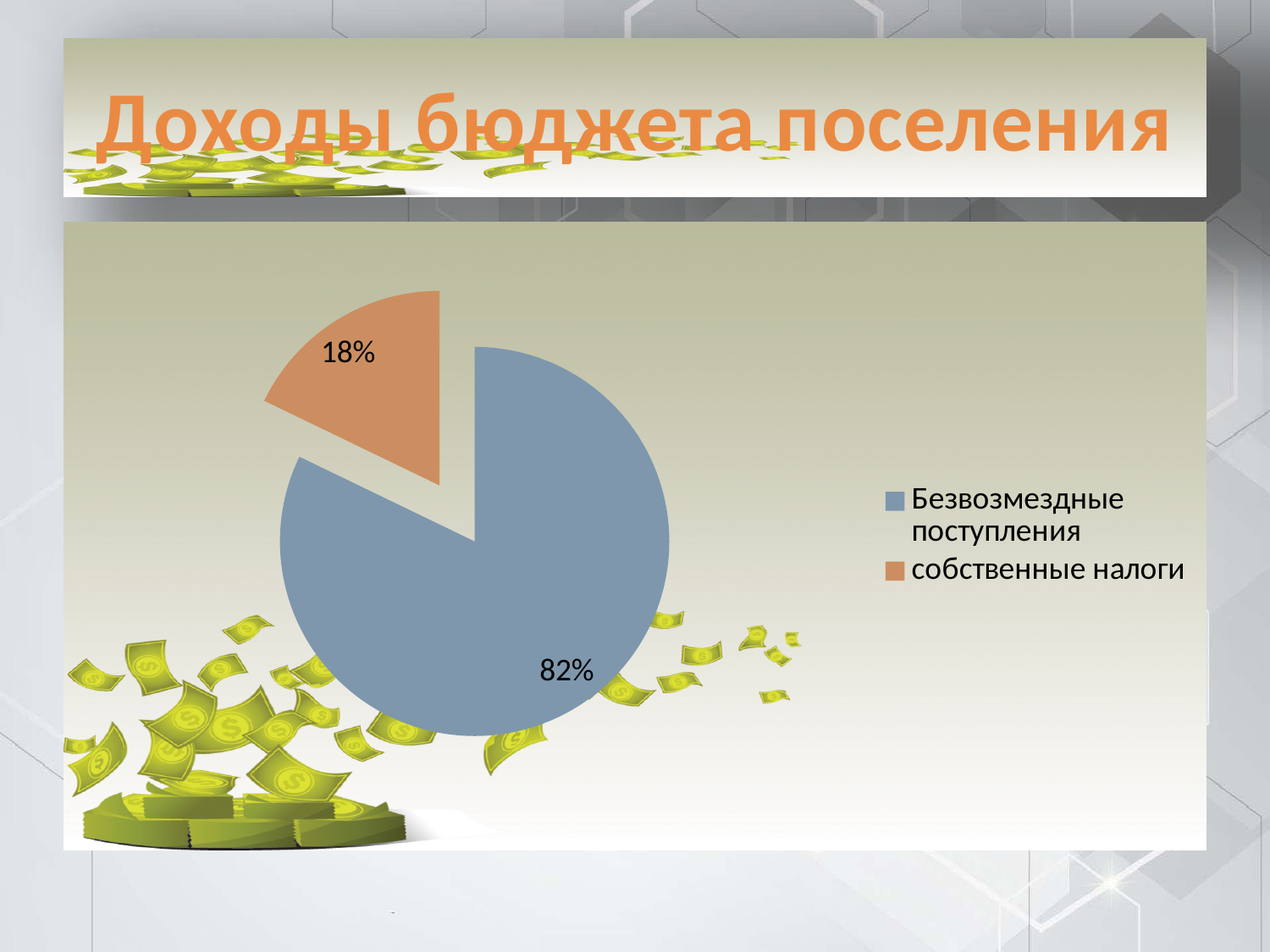
How many slices does the pie chart have? 2 What is the title of the slide? Доходы бюджета поселения Which slice is the largest? Безвозмездные поступления What share of the pie does Безвозмездные поступления take? 82% What kind of chart is shown on the slide? pie chart Which slice is the smallest? собственные налоги What is the difference in percentage points between Безвозмездные поступления and собственные налоги? 64 What share of the pie does собственные налоги take? 18% What colour is the slice for собственные налоги? orange How many entries does the legend list? 2 Which is larger, Безвозмездные поступления or собственные налоги? Безвозмездные поступления